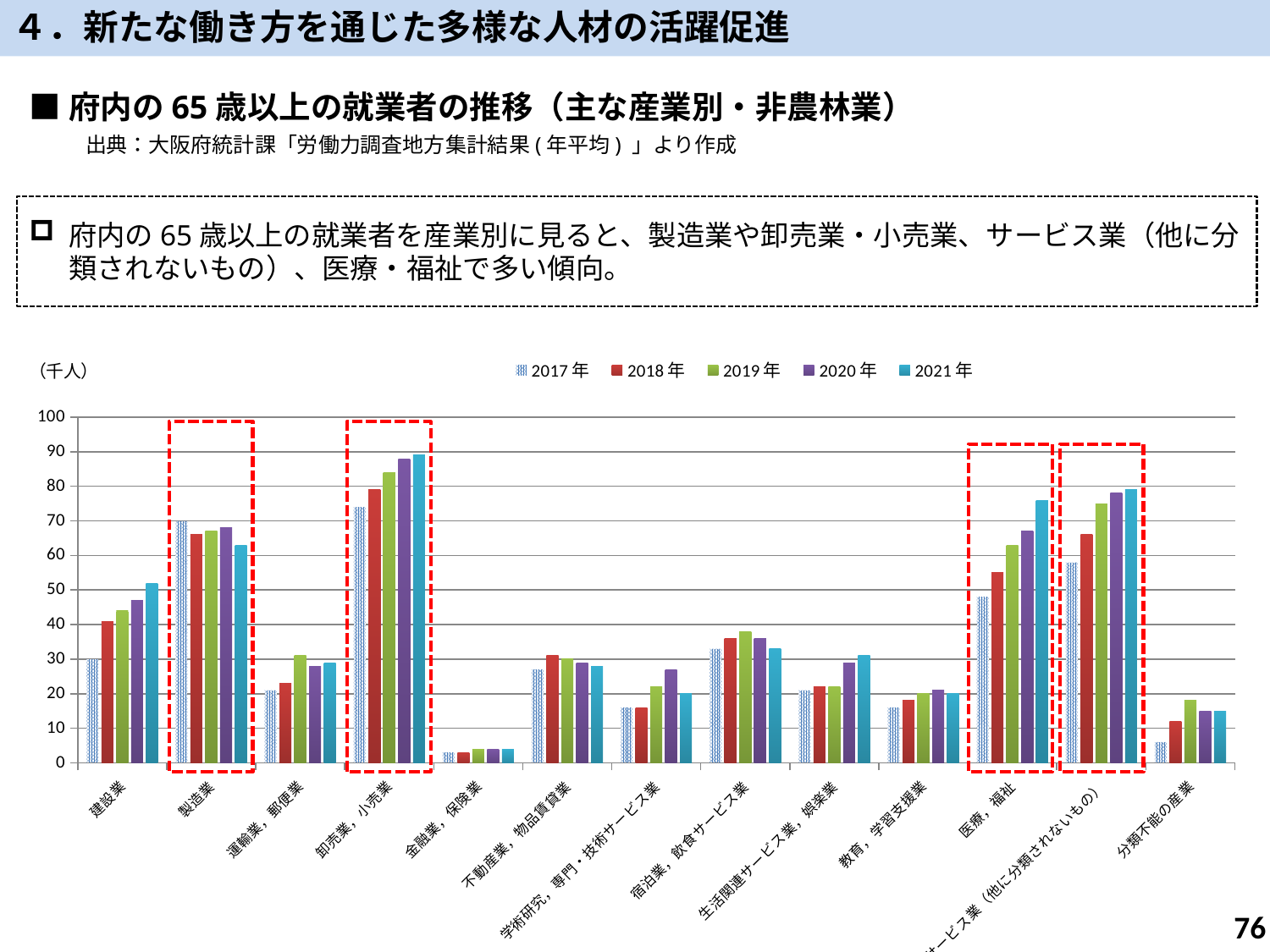
Which is larger for 2021年: 医療，福祉 or 製造業? 医療，福祉 Which industry has the lowest value for 2021年? 金融業，保険業 How many series does the legend list? 5 Is the value for 金融業，保険業 in 2021年 greater or less than 10? less How many industry categories are shown on the x axis? 13 Which industry has the highest value for 2021年? 卸売業，小売業 Is the value for 建設業 in 2017年 greater or less than 40? less Is the value for 卸売業，小売業 in 2021年 greater or less than 80? greater Do the values for 医療，福祉 rise or fall from 2017年 to 2021年? rise What kind of chart is shown on the slide? bar chart What unit is shown at the top left of the chart's vertical axis? 千人